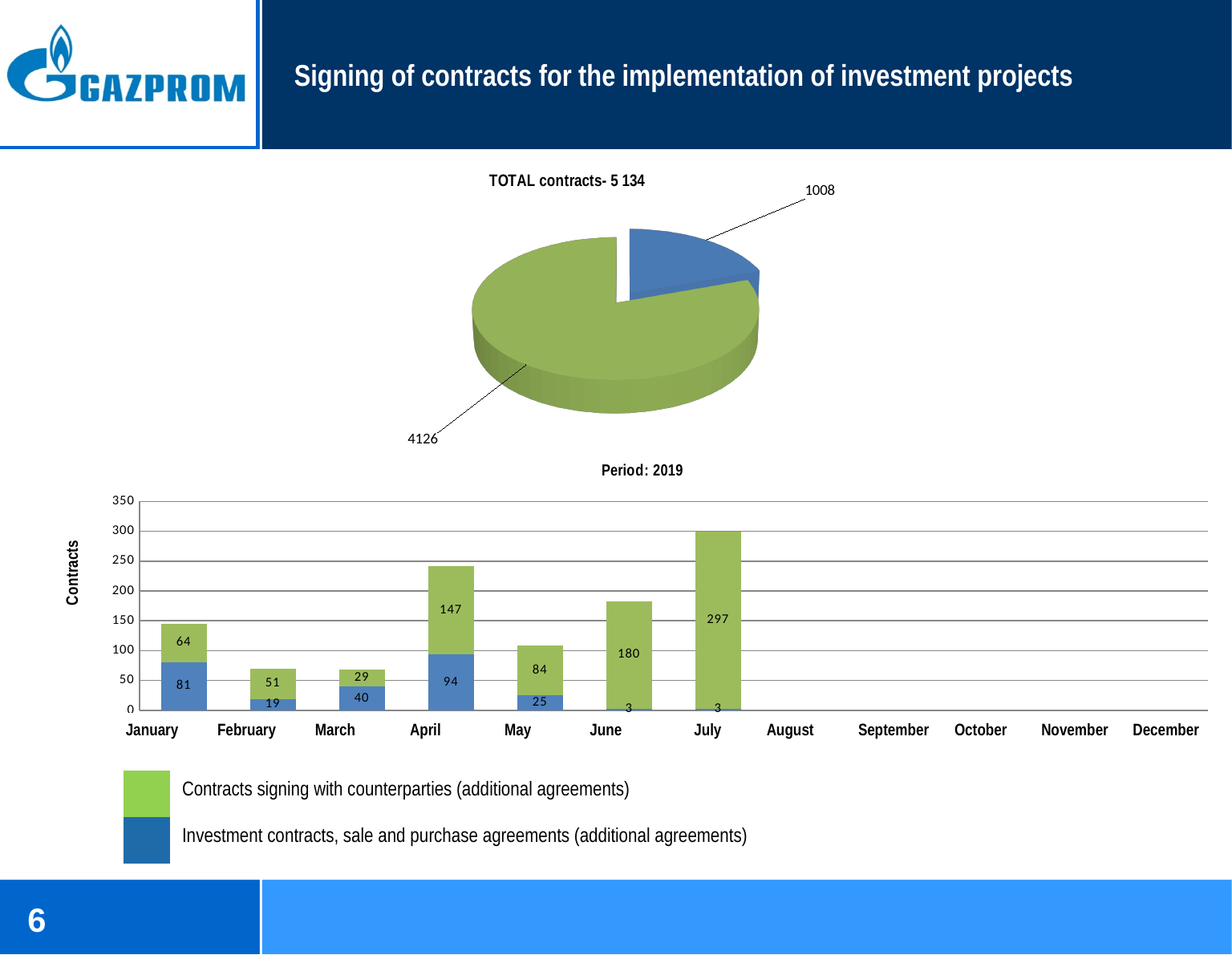
In the bar chart titled 'Period: 2019', what is the total height of the stacked bar for April? 241 In the pie chart titled 'TOTAL contracts- 5 134', which slice is larger, the green one or the blue one? the green one In the bar chart titled 'Period: 2019', which month has the highest value for 'Contracts signing with counterparties (additional agreements)'? July In the bar chart titled 'Period: 2019', what is the value of 'Contracts signing with counterparties (additional agreements)' for July? 297 In the bar chart titled 'Period: 2019', what is the difference between the 'Contracts signing with counterparties (additional agreements)' values for July and June? 117 In the pie chart titled 'TOTAL contracts- 5 134', what is the value of the blue slice? 1008 In the bar chart titled 'Period: 2019', how many months are shown on the x axis? 12 What kind of chart is the chart titled 'Period: 2019'? stacked bar chart How many series does the legend below the bar chart list? 2 In the bar chart titled 'Period: 2019', which month has the lowest value for 'Contracts signing with counterparties (additional agreements)'? March In the pie chart titled 'TOTAL contracts- 5 134', what is the value of the green slice? 4126 In the bar chart titled 'Period: 2019', what is the value of 'Investment contracts, sale and purchase agreements (additional agreements)' for April? 94